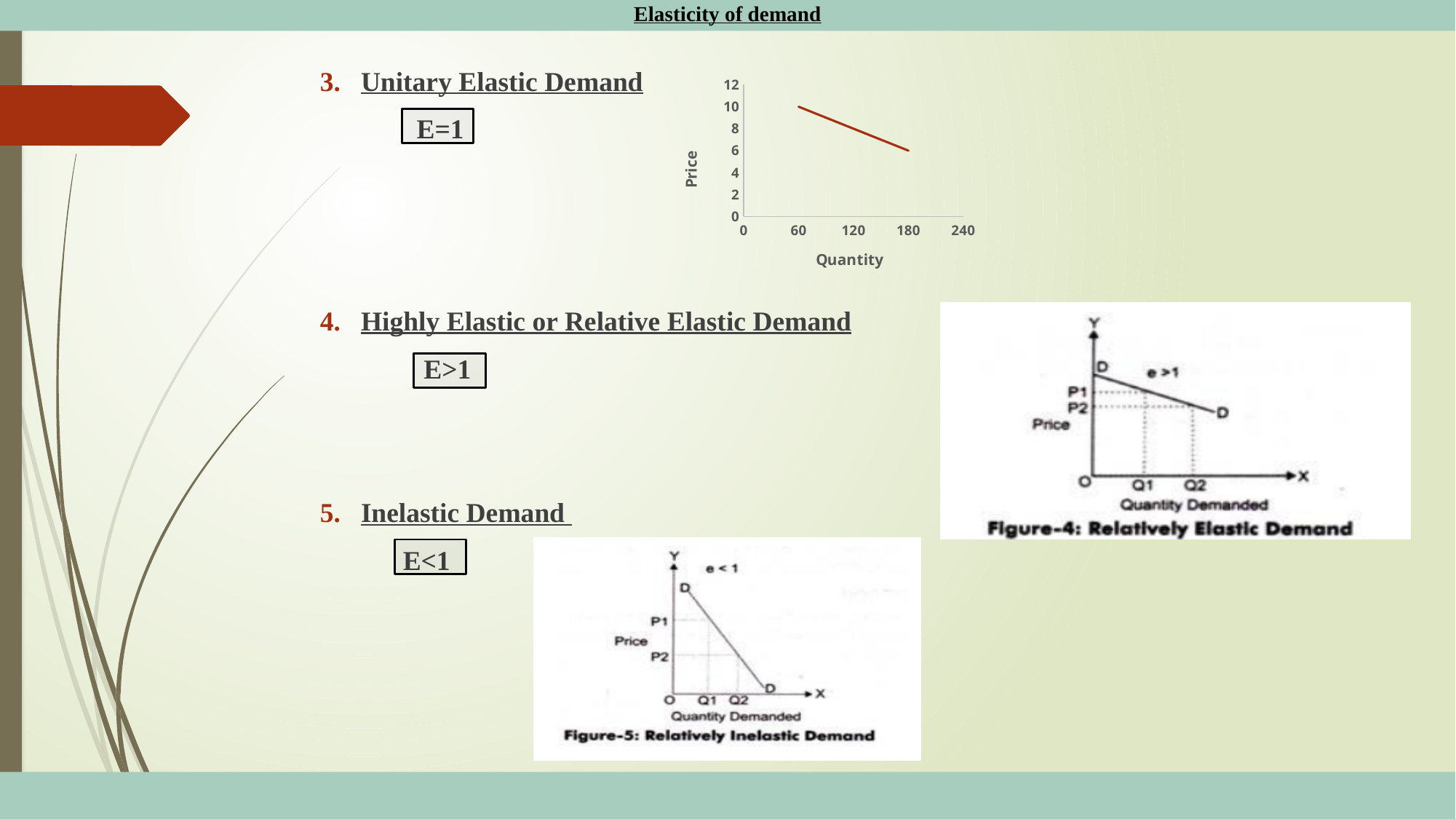
In the Price versus Quantity chart, does the price rise or fall as quantity increases? fall In the Price versus Quantity chart, what is the price when the quantity is 60? 10 In the Price versus Quantity chart, is the price at quantity 120 greater or less than 10? less In the Price versus Quantity chart, is the price at quantity 120 greater or less than 6? greater In the Price versus Quantity chart, what is the highest value shown on the Quantity axis? 240 In the Price versus Quantity chart, what is the price when the quantity is 180? 6 What kind of chart is the Price versus Quantity chart next to 'Unitary Elastic Demand'? line chart In the Price versus Quantity chart, which quantity has the higher price, 60 or 180? 60 In the Price versus Quantity chart, what is the label of the vertical axis? Price In the Price versus Quantity chart, what is the difference between the price at quantity 60 and the price at quantity 180? 4